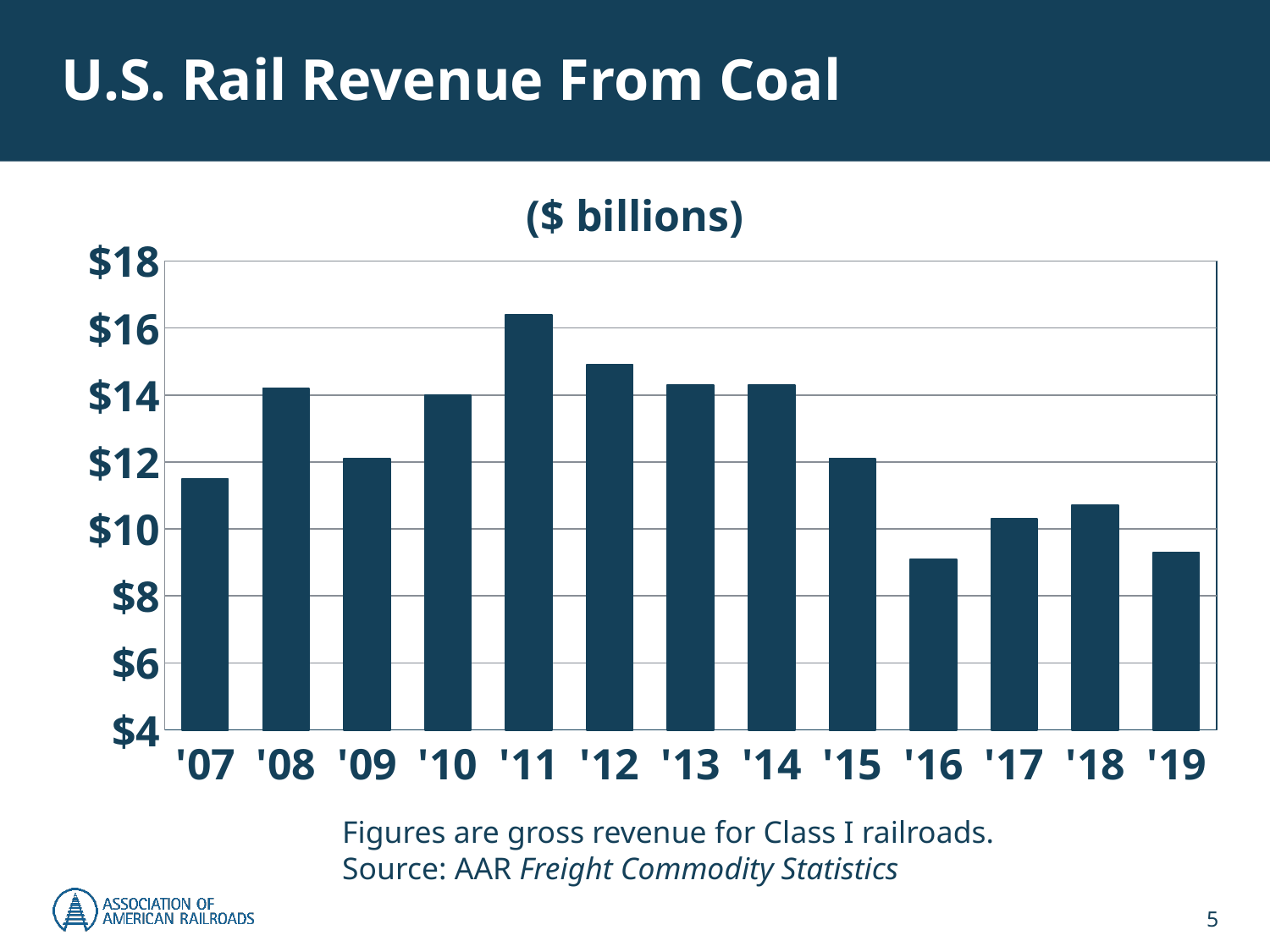
Do the values rise or fall from '14 to '16? fall Which is larger, the value for '11 or the value for '12? '11 How many years are plotted on the chart? 13 In what units are the values on the chart expressed? $ billions Which year has the highest U.S. rail revenue from coal? '11 Is the value for '16 greater or less than $10 billion? less Is the value for '07 greater or less than $12 billion? less Is the value for '18 greater or less than $10 billion? greater What kind of chart is shown on the slide? bar chart Which is larger, the value for '15 or the value for '16? '15